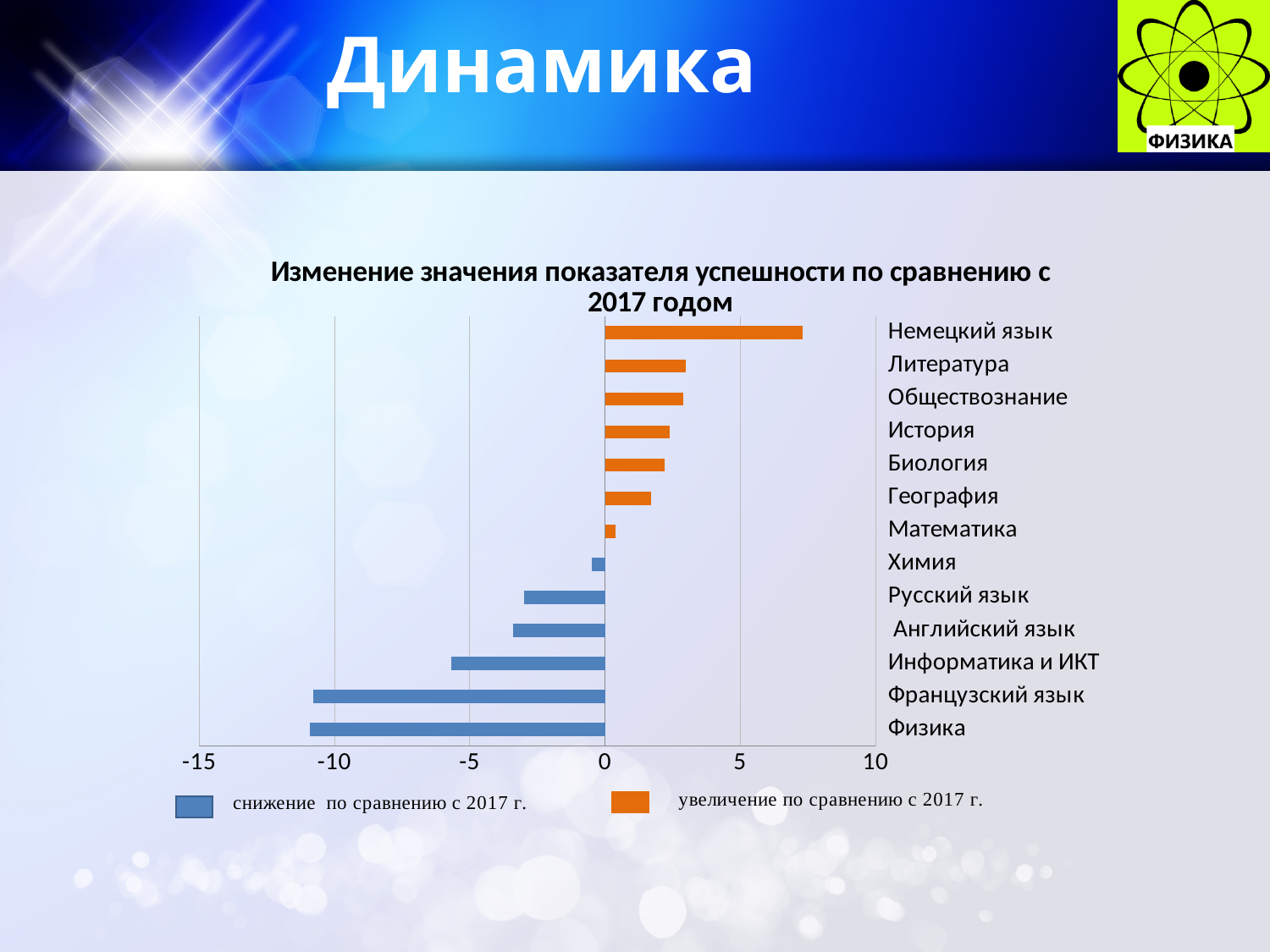
Is the value for Информатика и ИКТ greater or less than -5? less Is the value for Французский язык greater or less than -10? less According to the legend, what does the orange colour of a bar indicate? увеличение по сравнению с 2017 г. Is the value for Литература greater or less than 5? less What kind of chart is shown on the slide? bar chart How many subjects (categories) are plotted in the chart? 13 Which has the larger value, Русский язык or Информатика и ИКТ? Русский язык Which has the larger value, Немецкий язык or Литература? Немецкий язык What is the title of the chart? Изменение значения показателя успешности по сравнению с 2017 годом Which subject has the highest value in the chart? Немецкий язык